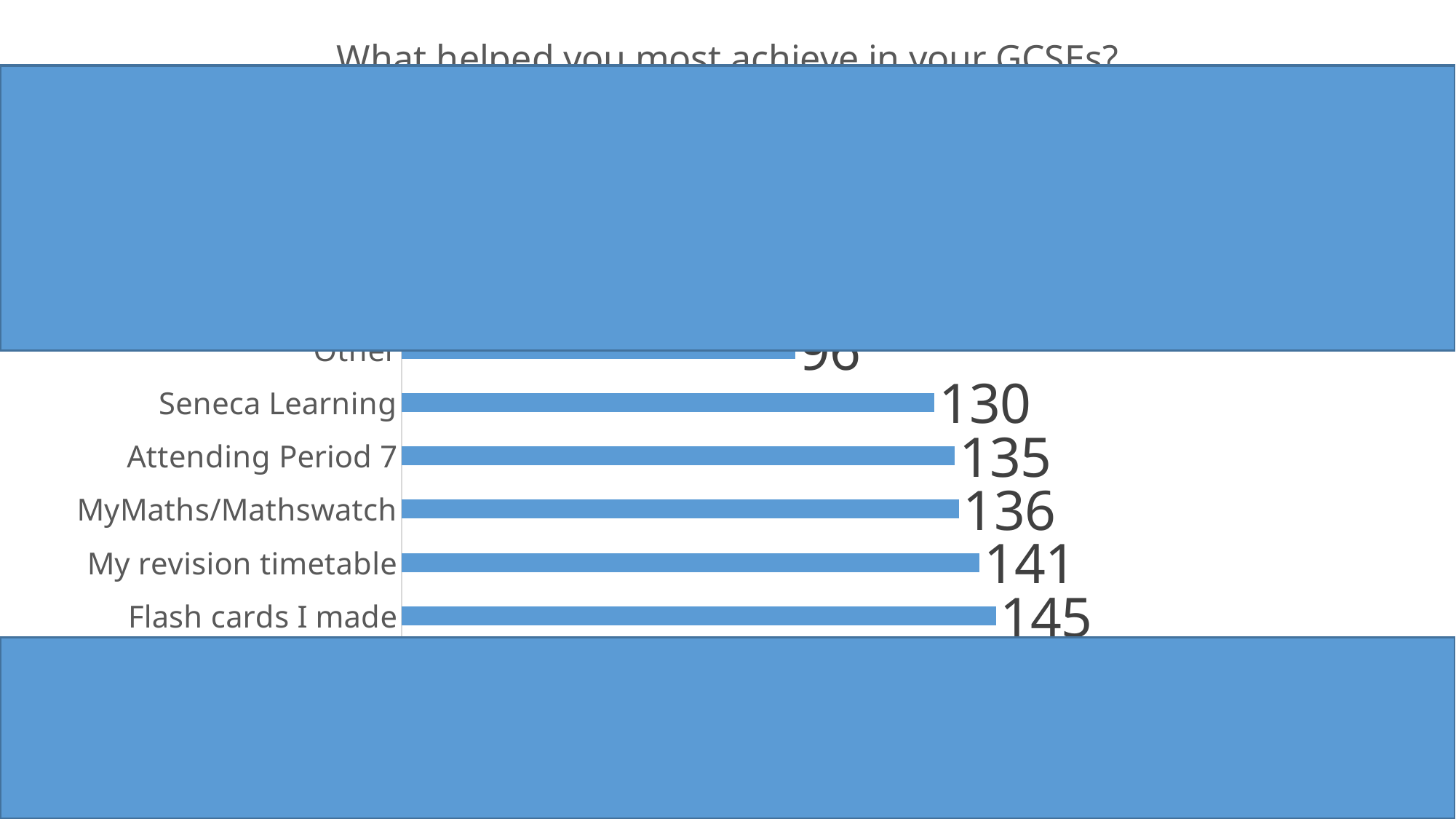
What is the value for Flash cards I made? 145 What is the difference between the values for MyMaths/Mathswatch and Attending Period 7? 1 What kind of chart is shown on the slide? Bar chart Which is larger, the value for My revision timetable or the value for Attending Period 7? My revision timetable What is the title of the chart? What helped you most achieve in your GCSEs? What is the value for MyMaths/Mathswatch? 136 What is the value for My revision timetable? 141 Which is larger, the value for Flash cards I made or the value for Seneca Learning? Flash cards I made What is the difference between the values for Flash cards I made and Seneca Learning? 15 What is the difference between the values for My revision timetable and MyMaths/Mathswatch? 5 What is the value for Seneca Learning? 130 What is the value for Attending Period 7? 135